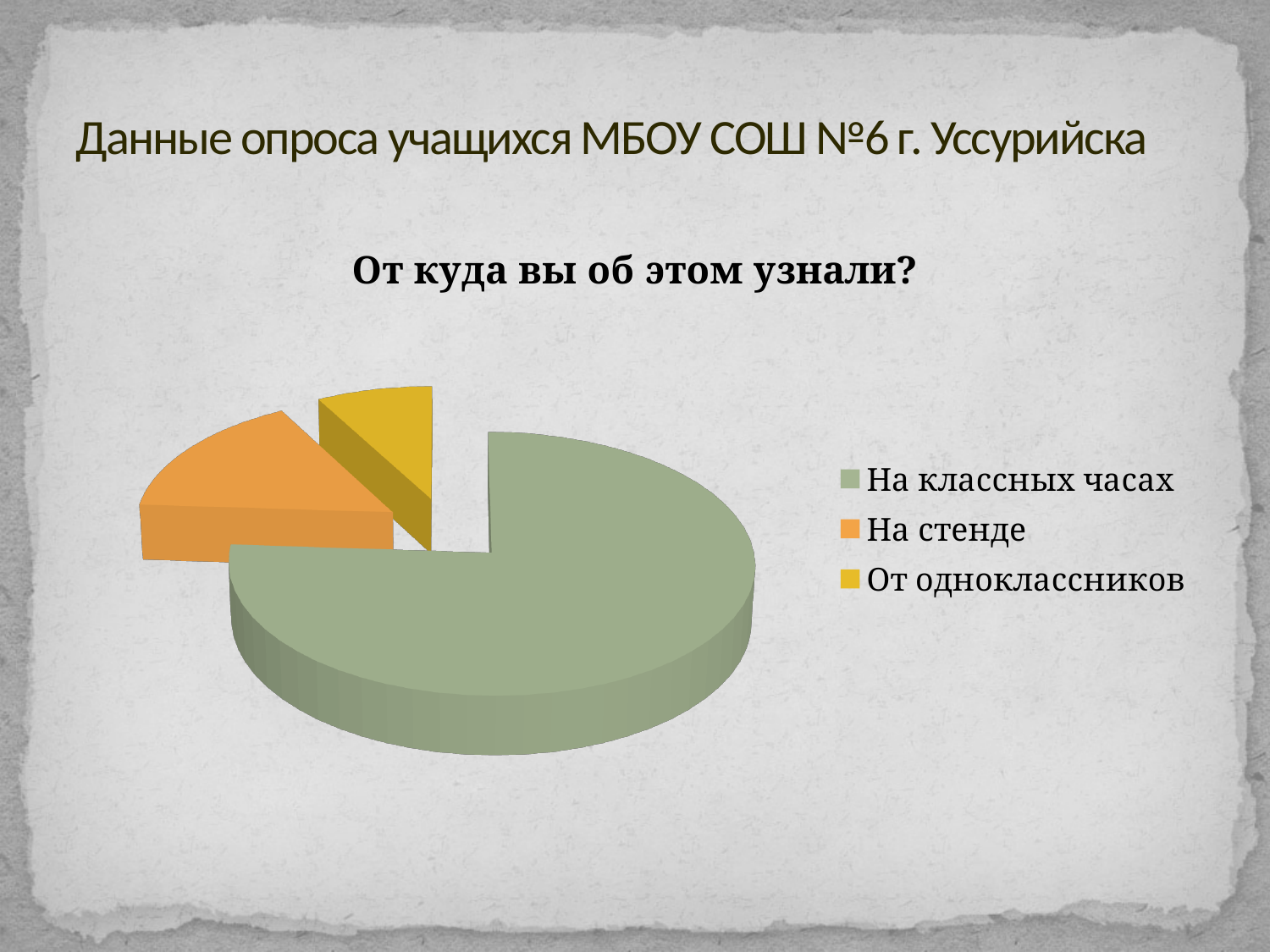
What is the title of the chart? От куда вы об этом узнали? Which category has the largest slice of the pie? На классных часах Which is larger: the slice for "На классных часах" or the slice for "На стенде"? На классных часах How many slices does the pie chart have? 3 How many entries does the legend list? 3 Which category has the smallest slice of the pie? От одноклассников What colour is the slice for "На стенде"? Orange What kind of chart is shown on the slide? Pie chart Which is larger: the slice for "На стенде" or the slice for "От одноклассников"? На стенде